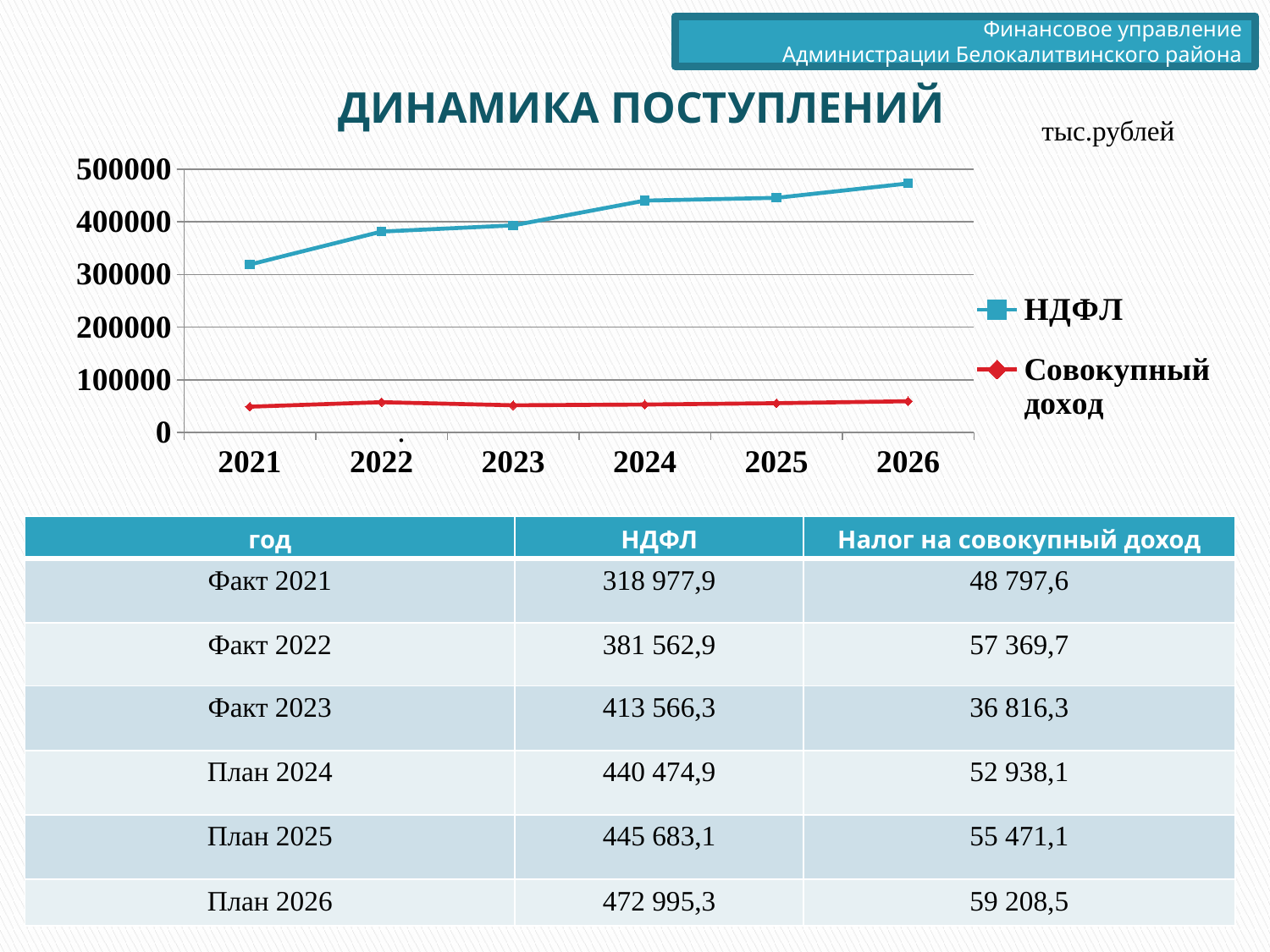
Does the НДФЛ line rise or fall from 2021 to 2026? Rises In which year is НДФЛ highest? 2026 What type of chart is shown on the slide? Line chart How many series does the chart legend list? 2 What is the НДФЛ value for 2021? 318 977,9 In which year is НДФЛ lowest? 2021 How many years are plotted along the x axis of the chart? 6 What is the difference between the НДФЛ values for 2026 and 2021? 154 017,4 What is the Налог на совокупный доход value for 2025? 55 471,1 Is the НДФЛ value for 2021 greater or less than 300000? greater What is the НДФЛ value for 2026? 472 995,3 Which is larger: НДФЛ in 2024 or Совокупный доход in 2024? НДФЛ